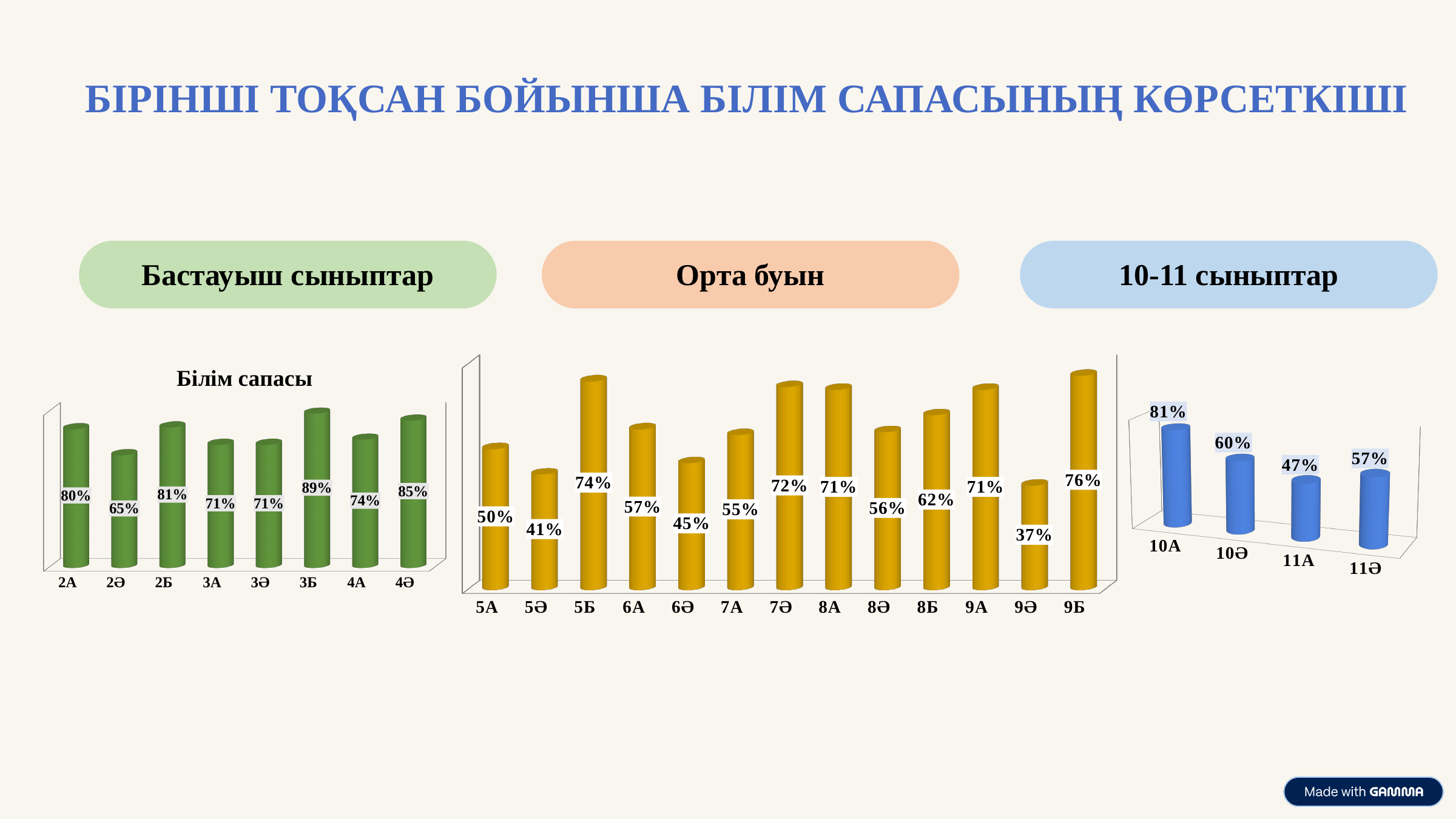
In the middle chart (Орта буын), which class has the highest value? 9Б In the left chart (Бастауыш сыныптар), which class has the lowest value? 2Ә In the right chart (10-11 сыныптар), what is the difference between 10А and 10Ә? 21% In the middle chart (Орта буын), how many classes are shown? 13 In the left chart (Бастауыш сыныптар), what is the value for 3Б? 89% In the right chart (10-11 сыныптар), what is the value for 11А? 47% In the left chart (Бастауыш сыныптар), what is the difference between 4Ә and 4А? 11% In the middle chart (Орта буын), which is larger, 5Б or 7Ә? 5Б What type of chart is the right chart (10-11 сыныптар)? Bar chart In the middle chart (Орта буын), what is the value for 8Б? 62% In the left chart (Бастауыш сыныптар), how many classes are shown? 8 In the middle chart (Орта буын), which class has the lowest value? 9Ә